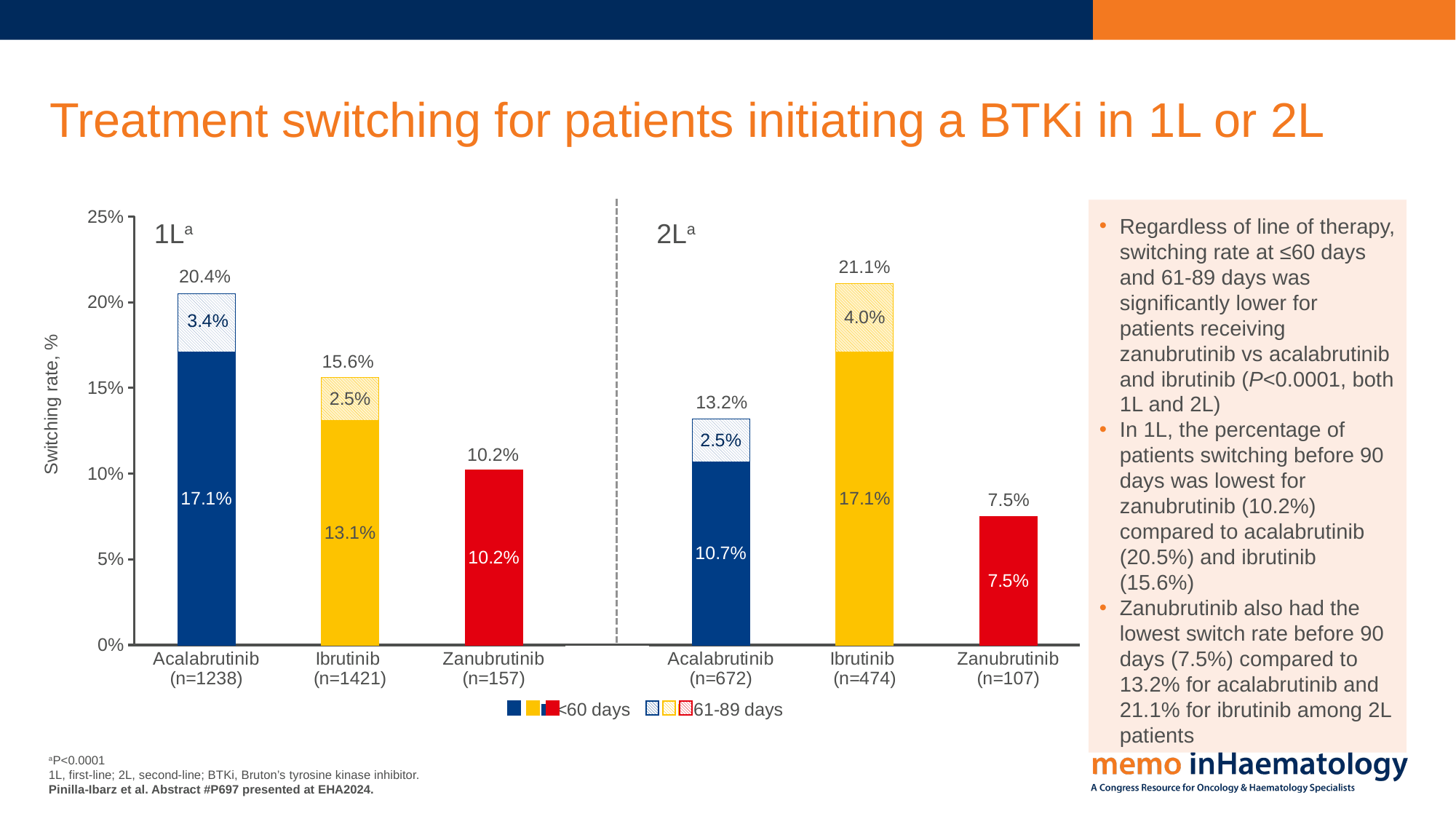
How many bars are plotted in the chart in total across both panels? 6 What is the total switching rate for acalabrutinib in the 1L panel? 20.4% Which drug has the highest total switching rate in the 2L panel? Ibrutinib How many series does the legend list? 2 What is the difference between the total switching rates of ibrutinib and zanubrutinib in the 2L panel? 13.6% Is the total switching rate for acalabrutinib higher in the 1L panel or the 2L panel? 1L Is the total switching rate for zanubrutinib in the 2L panel greater or less than 10%? less In the 1L panel, what is the 61-89 days switching rate for acalabrutinib? 3.4% What is the label of the y axis? Switching rate, % What kind of chart is shown on the slide? Stacked bar chart In the 2L panel, what is the switching rate at <60 days for ibrutinib? 17.1% Which drug has the lowest total switching rate in the 1L panel? Zanubrutinib